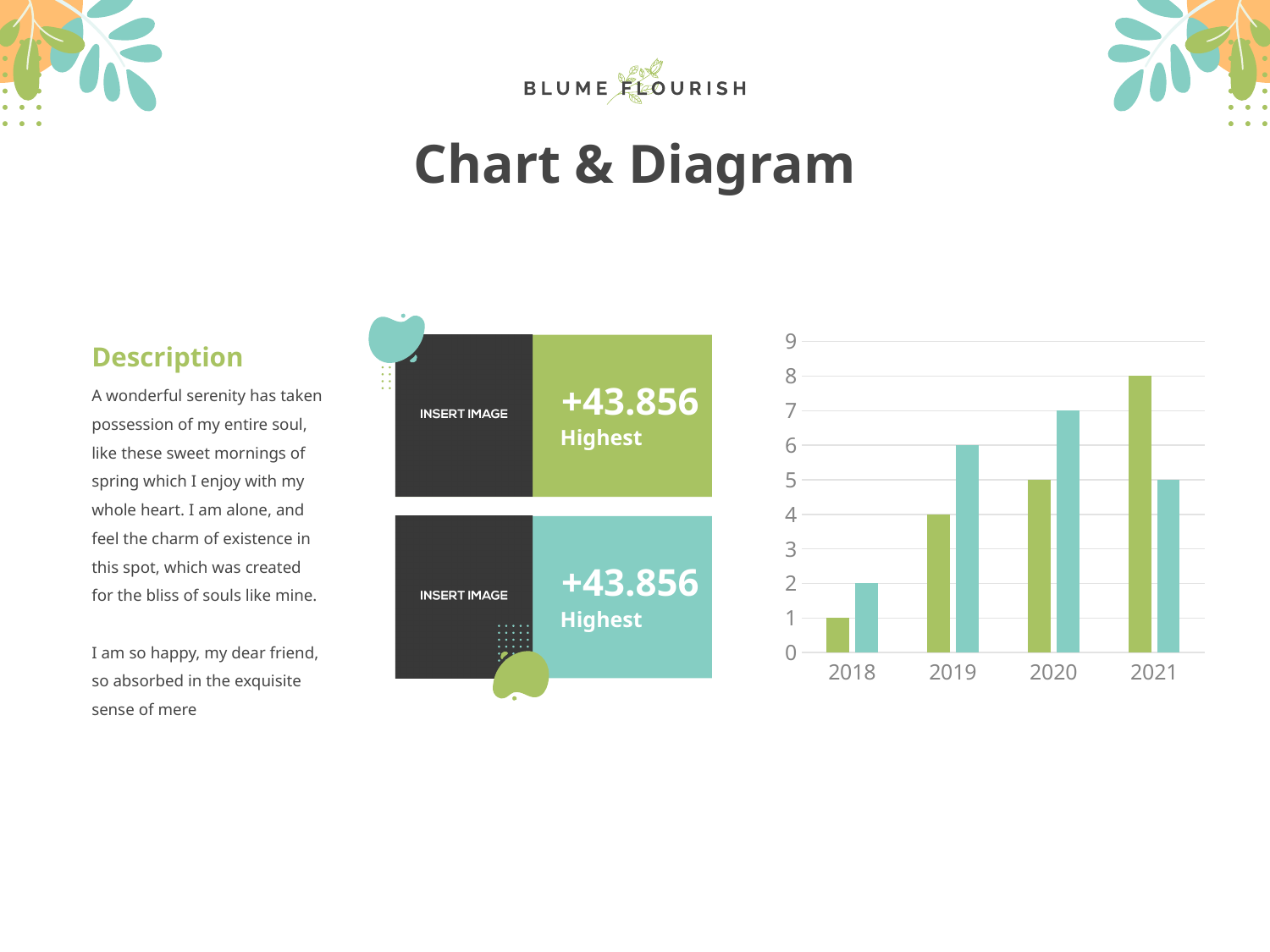
In which year is the teal bar the lowest? 2018 Do the green bars rise or fall from 2018 to 2021? rise What is the value of the teal bar for 2019? 6 In which year is the green bar the highest? 2021 What is the value of the green bar for 2018? 1 How many years are shown on the x axis of the chart? 4 What is the difference between the green bar and the teal bar in 2021? 3 Which is larger in 2020, the green bar or the teal bar? the teal bar What kind of chart is shown on the slide? bar chart What is the highest value shown on the chart's vertical axis? 9 What is the value of the teal bar for 2020? 7 What is the value of the green bar for 2021? 8